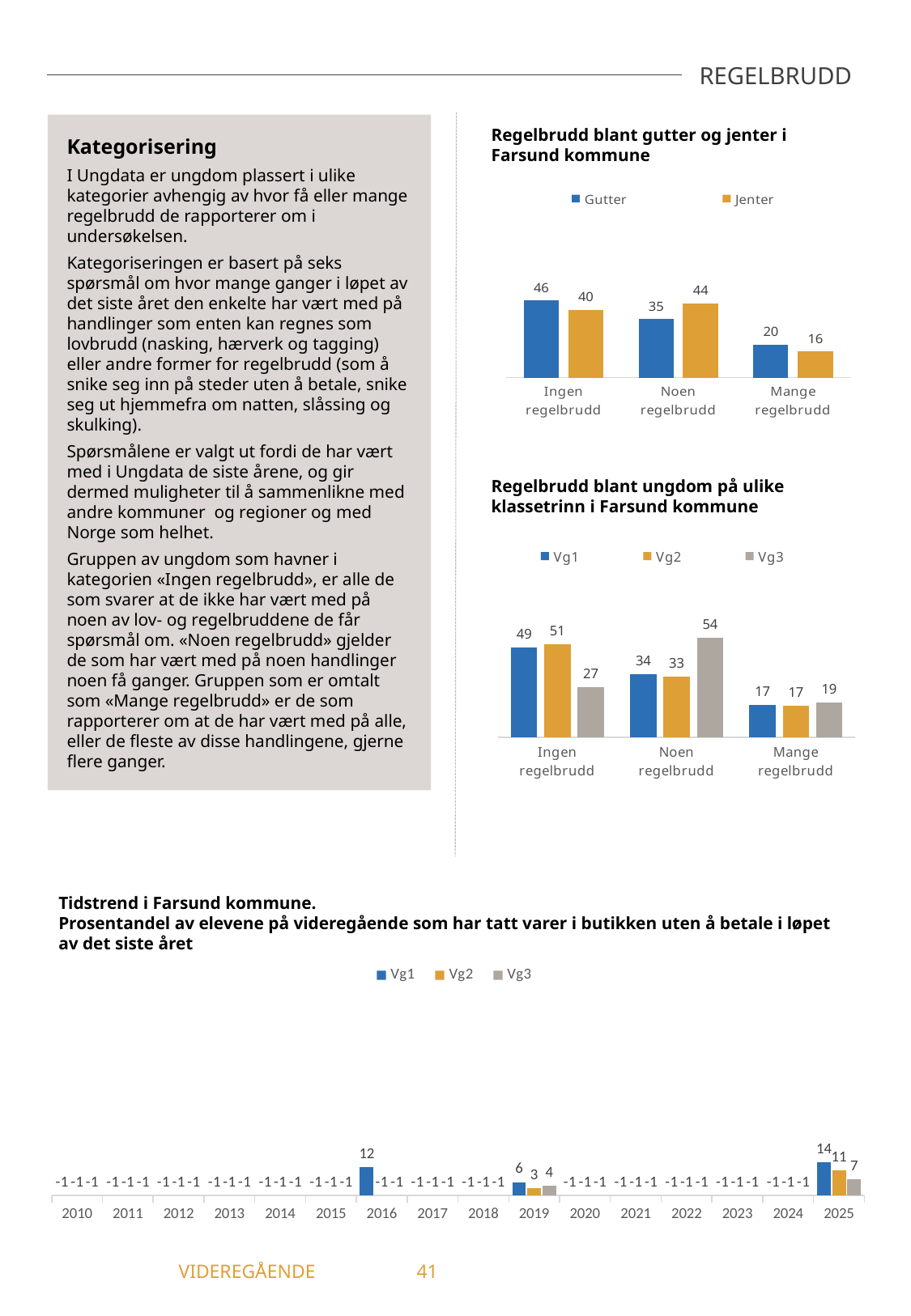
In the chart 'Regelbrudd blant gutter og jenter i Farsund kommune', what is the value for Jenter in the 'Noen regelbrudd' category? 44 In the chart 'Regelbrudd blant ungdom på ulike klassetrinn i Farsund kommune', what is the difference between Vg2 and Vg3 in the 'Ingen regelbrudd' category? 24 What kind of chart is 'Tidstrend i Farsund kommune'? Bar chart In the chart 'Tidstrend i Farsund kommune', what is the value for Vg2 in 2019? 3 In the chart 'Regelbrudd blant ungdom på ulike klassetrinn i Farsund kommune', which series has the highest value in the 'Noen regelbrudd' category? Vg3 In the chart 'Regelbrudd blant gutter og jenter i Farsund kommune', what is the difference between Gutter and Jenter in the 'Mange regelbrudd' category? 4 In the chart 'Regelbrudd blant gutter og jenter i Farsund kommune', what is the value for Gutter in the 'Ingen regelbrudd' category? 46 How many categories are shown on the x axis of the chart 'Regelbrudd blant ungdom på ulike klassetrinn i Farsund kommune'? 3 In the chart 'Tidstrend i Farsund kommune', what is the value for Vg1 in 2025? 14 How many series does the legend list in the chart 'Regelbrudd blant gutter og jenter i Farsund kommune'? 2 In the chart 'Regelbrudd blant ungdom på ulike klassetrinn i Farsund kommune', what is the value for Vg3 in the 'Ingen regelbrudd' category? 27 In the chart 'Regelbrudd blant gutter og jenter i Farsund kommune', which series has the higher value for 'Noen regelbrudd', Gutter or Jenter? Jenter